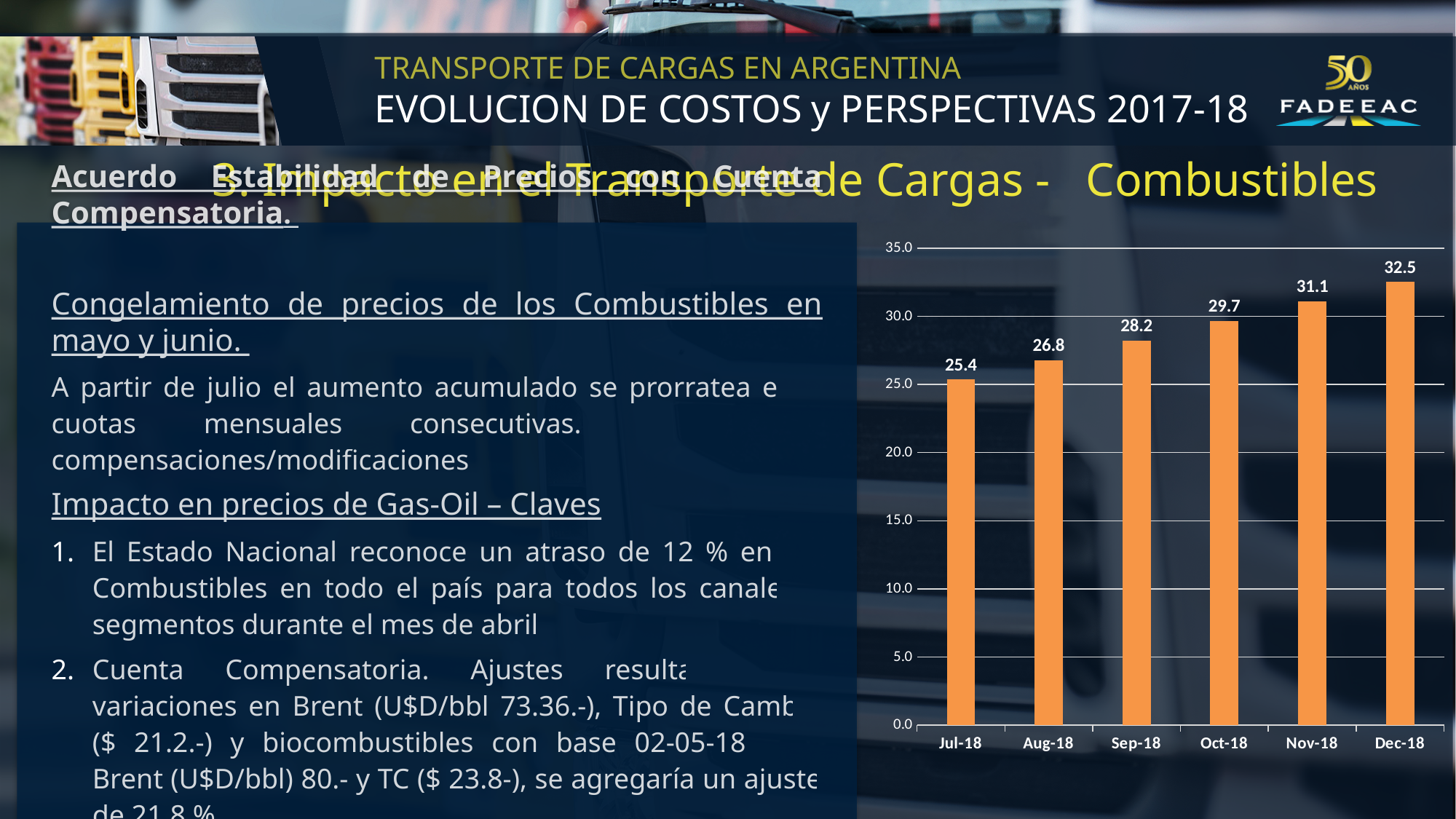
Which month has the highest value? Dec-18 What is the value for Jul-18? 25.4 Which is larger, the value for Aug-18 or the value for Oct-18? Oct-18 What kind of chart is shown on the slide? bar chart Which month has the lowest value? Jul-18 Is the value for Nov-18 greater or less than 30.0? greater Do the values rise or fall from Jul-18 to Dec-18? rise What is the difference between the values for Dec-18 and Jul-18? 7.1 How many months are shown on the x axis? 6 What is the difference between the values for Oct-18 and Aug-18? 2.9 What is the value for Sep-18? 28.2 What is the value for Nov-18? 31.1